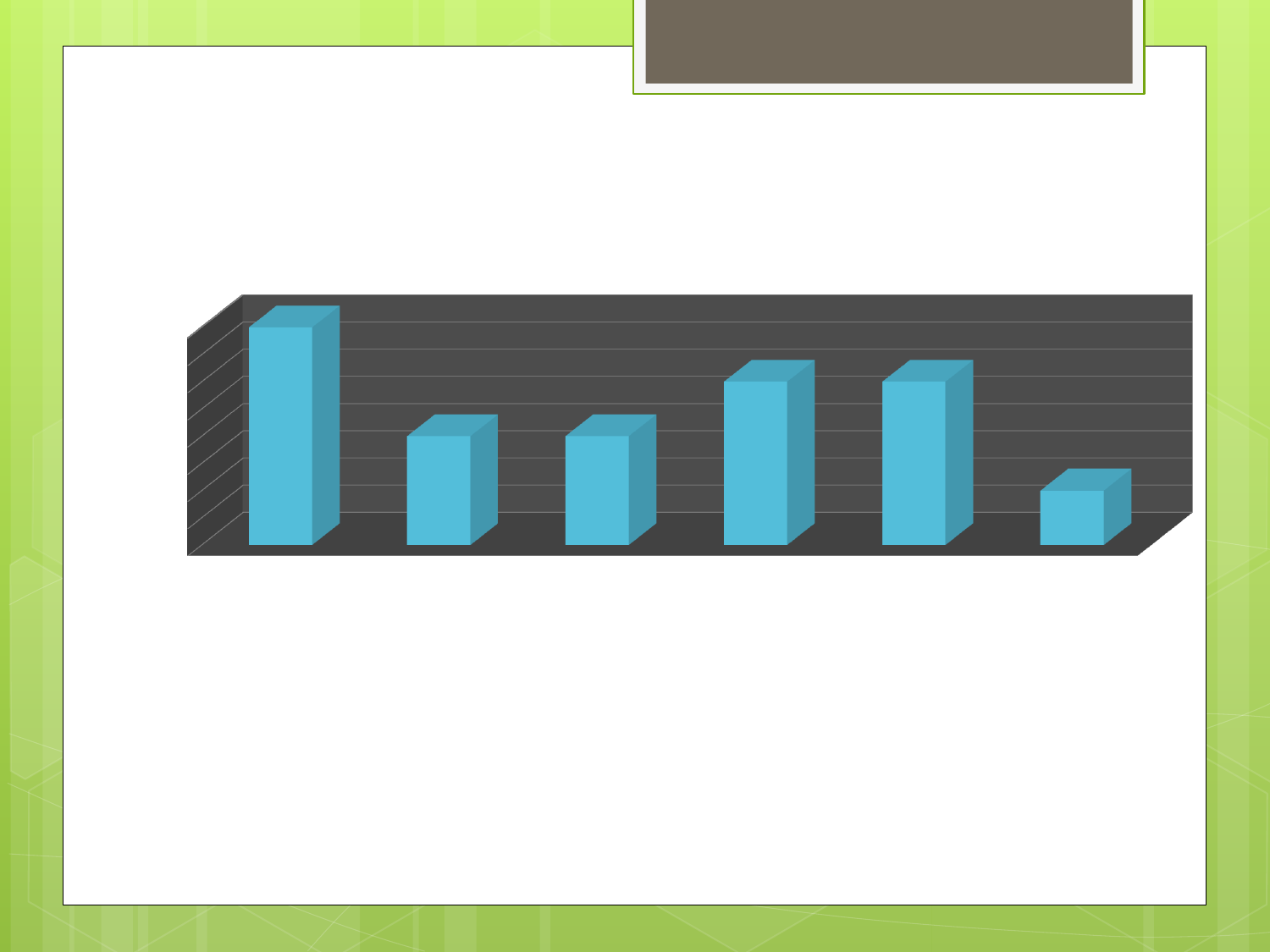
What colour are the bars in the chart? blue Does the chart display a legend? no Do the bar heights consistently decrease from left to right across the chart? no Which is taller, the fourth bar or the sixth bar? the fourth bar How many bars does the chart show? 6 Which is taller, the second bar or the fourth bar? the fourth bar Which bar in the chart is the shortest? the last (rightmost) bar Which bar in the chart is the tallest? the first (leftmost) bar Which is taller, the first bar or the second bar? the first bar What kind of chart is shown on the slide? bar chart